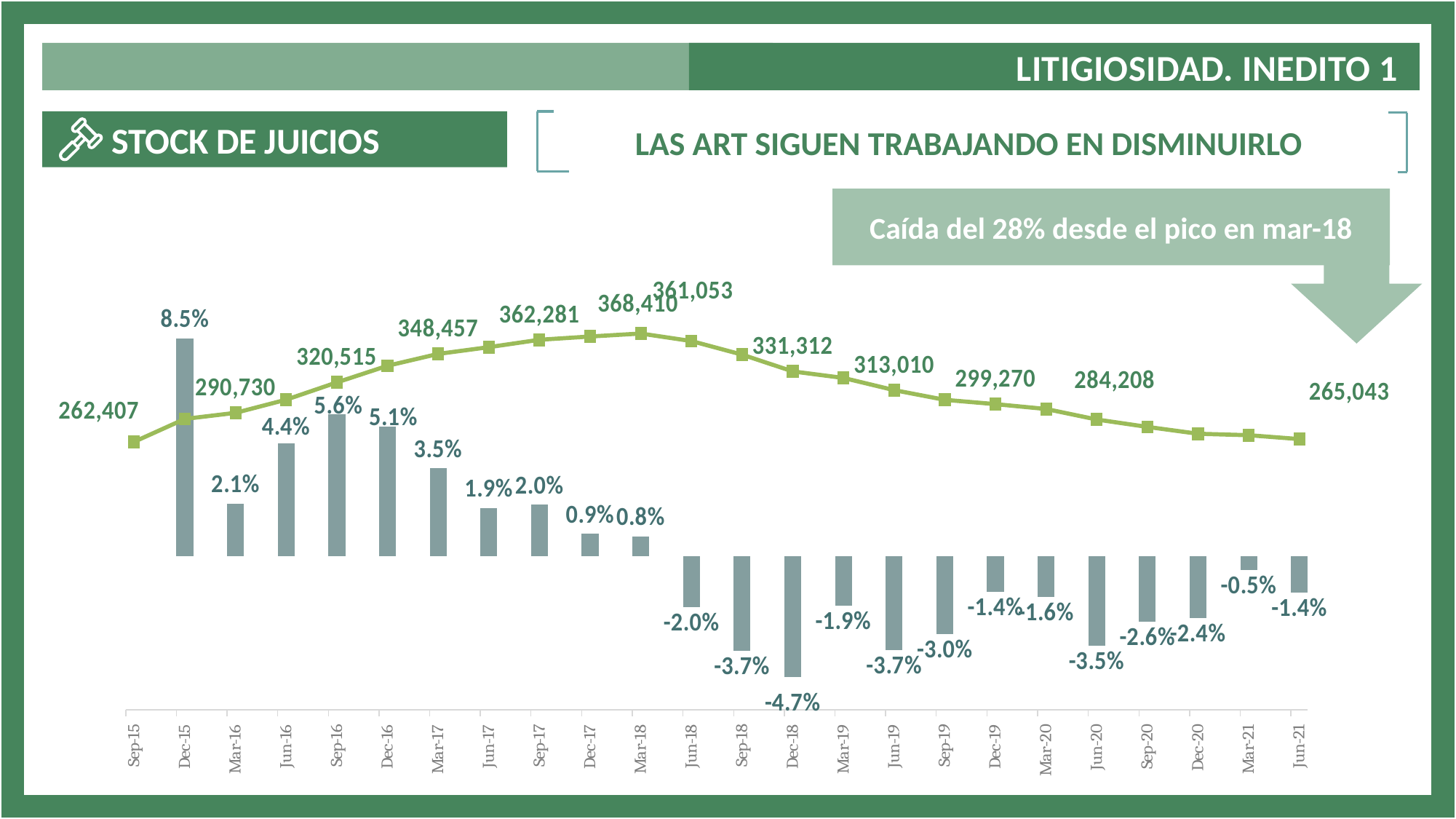
What is the percentage change shown for Mar-21? -0.5% What kind of chart is shown on the slide? A combined line and bar chart What is the highest value labelled on the line, at the peak in Mar-18? 368,410 What is the percentage change shown for Sep-16? 5.6% What is the stock of lawsuits (line value) labelled for Jun-21? 265,043 Which period has the highest percentage change bar, and what is its value? Dec-15, 8.5% How many quarterly periods are shown on the x axis of the chart? 24 What is the difference between the peak line value of 368,410 and the Jun-21 value of 265,043? 103,367 Which period has the lowest percentage change bar, and what is its value? Dec-18, -4.7% Does the line rise or fall from Mar-18 to Jun-21? Fall What is the stock of lawsuits (line value) labelled for Sep-15? 262,407 Which percentage change bar is larger, Sep-16 or Dec-16? Sep-16